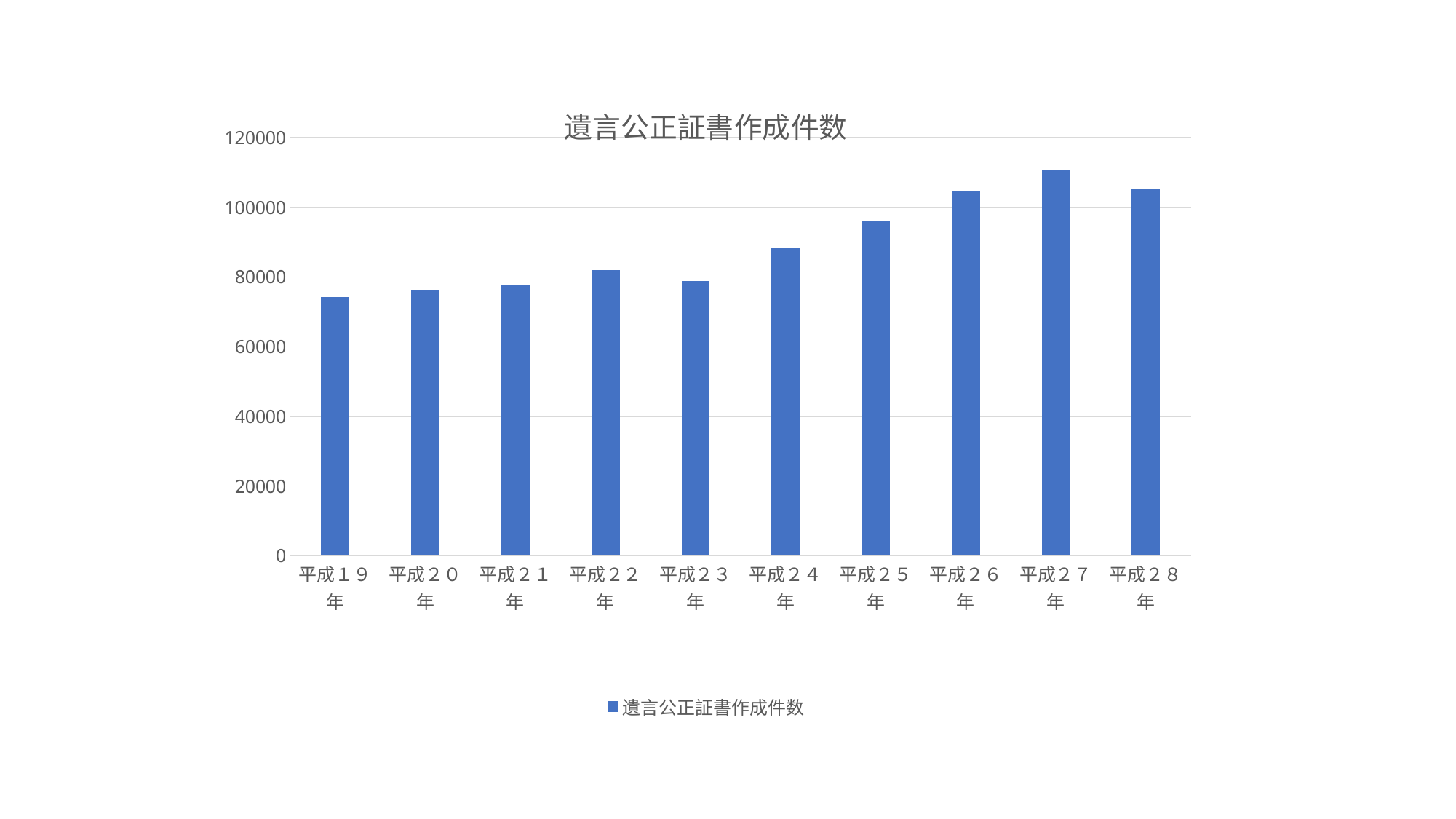
How many categories (years) are plotted on the x axis? 10 Do the values generally rise or fall from 平成１９年 to 平成２７年? rise Is the value for 平成２７年 greater or less than 100000? greater Is the value for 平成１９年 greater or less than 80000? less Which year has the lowest value? 平成１９年 Which is larger, the value for 平成２４年 or the value for 平成２５年? 平成２５年 How many series does the legend list? 1 What is the title of the chart? 遺言公正証書作成件数 Which year has the highest value? 平成２７年 Is the value for 平成２４年 greater or less than 80000? greater What kind of chart is shown on the slide? bar chart